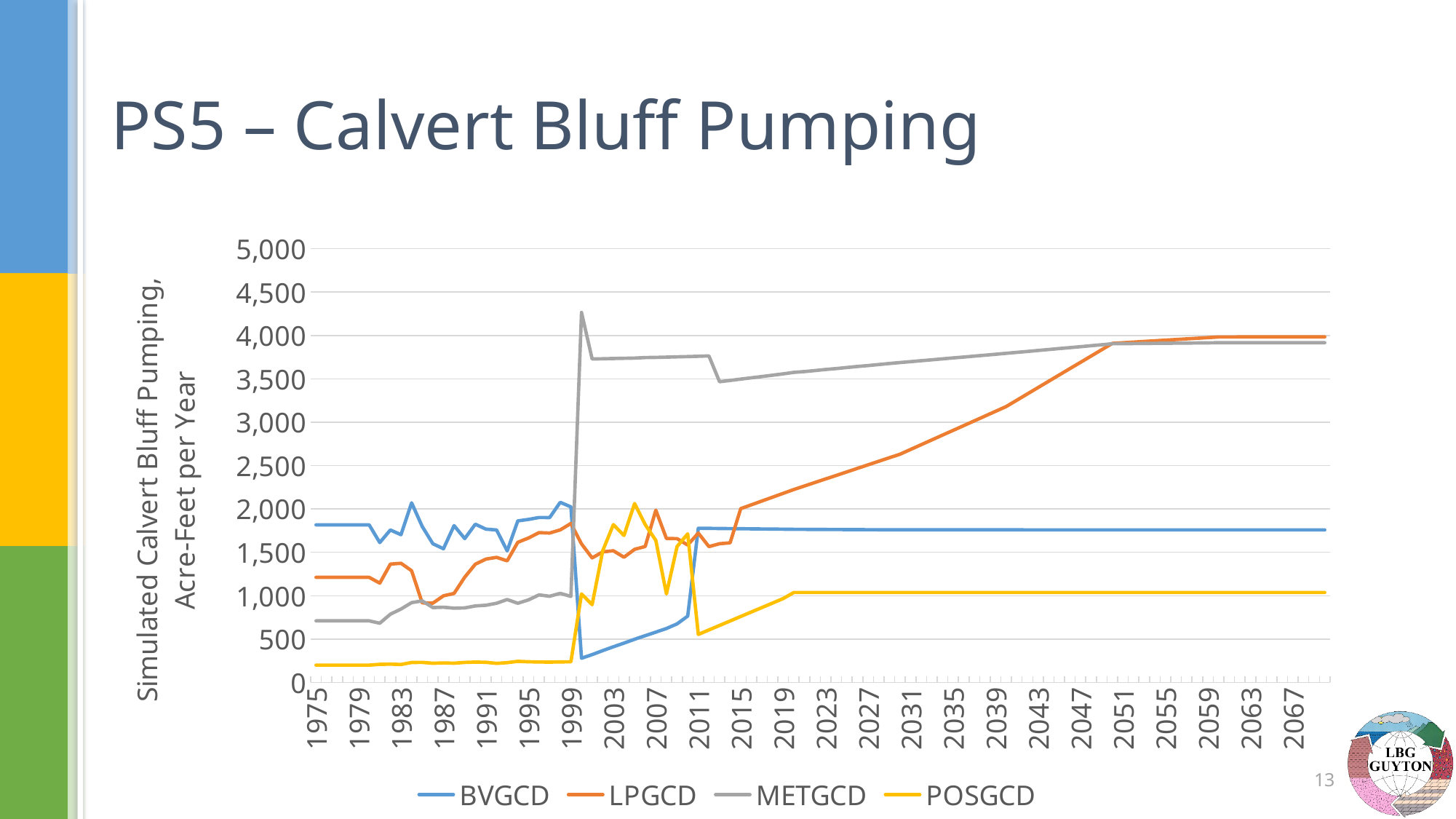
Is the value for POSGCD in 1975 greater or less than 500? less Which series has the lowest value in 2035? POSGCD In 1975, which is larger: BVGCD or LPGCD? BVGCD Is the value for METGCD in 2000 greater or less than 4,000? greater Does the LPGCD series rise or fall between 2015 and 2051? Rise How many series does the legend list? 4 Which series is drawn in grey? METGCD Which series has the highest value in 2035? METGCD Is the value for METGCD in 1975 greater or less than 1,000? less What kind of chart is shown on the slide? Line chart What is the label on the vertical axis? Simulated Calvert Bluff Pumping, Acre-Feet per Year